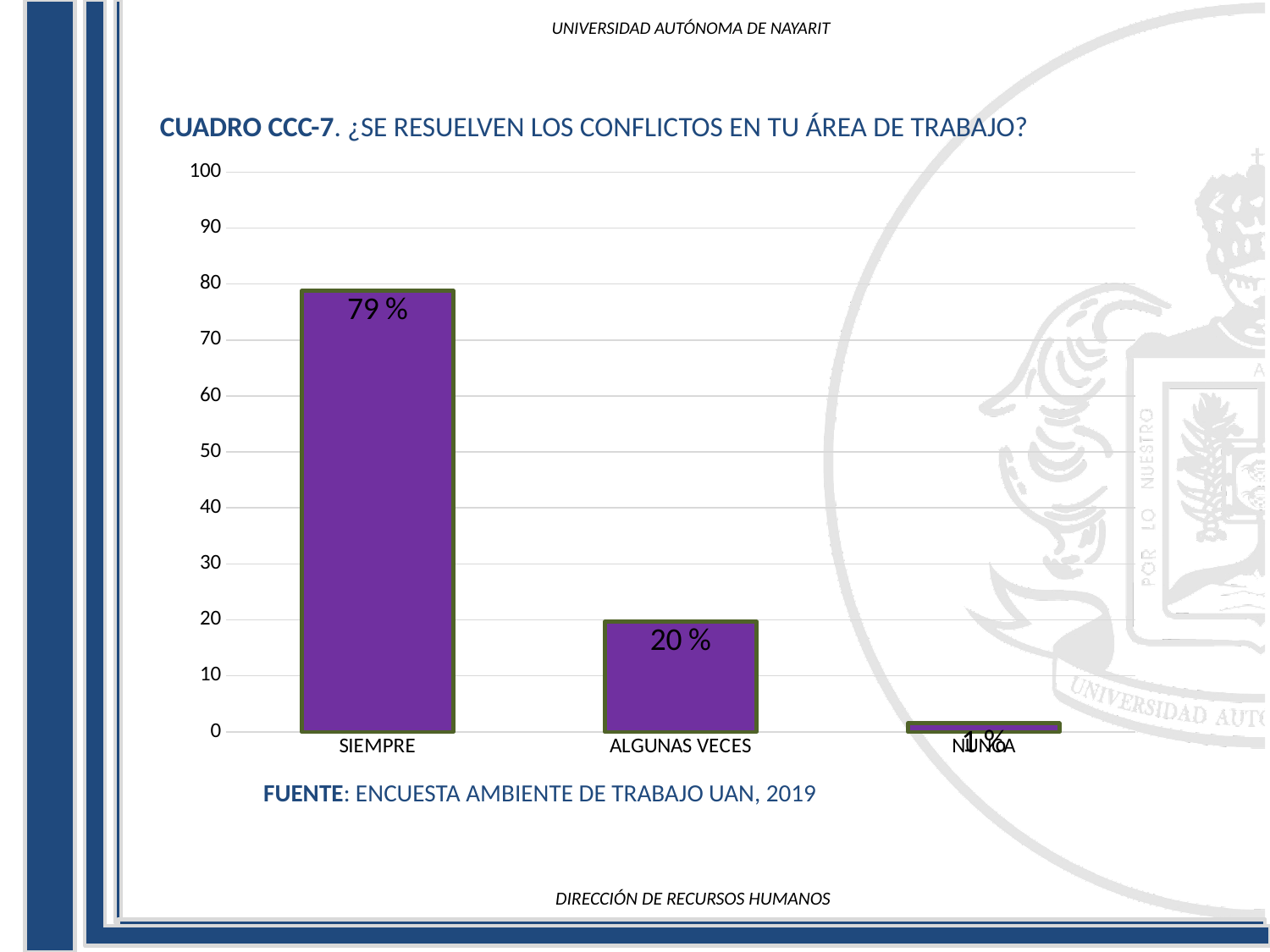
Is the value for SIEMPRE greater or less than 70? greater What is the difference between the values for SIEMPRE and ALGUNAS VECES? 59 % Which category has the highest value? SIEMPRE What is the value for ALGUNAS VECES? 20 % How many categories are shown on the x axis? 3 What kind of chart is shown on the slide? bar chart What is the title of the chart? CUADRO CCC-7. ¿SE RESUELVEN LOS CONFLICTOS EN TU ÁREA DE TRABAJO? Which is larger, the value for ALGUNAS VECES or the value for NUNCA? ALGUNAS VECES Which category has the lowest value? NUNCA What is the difference between the values for ALGUNAS VECES and NUNCA? 19 % What is the value for NUNCA? 1 % What is the value for SIEMPRE? 79 %